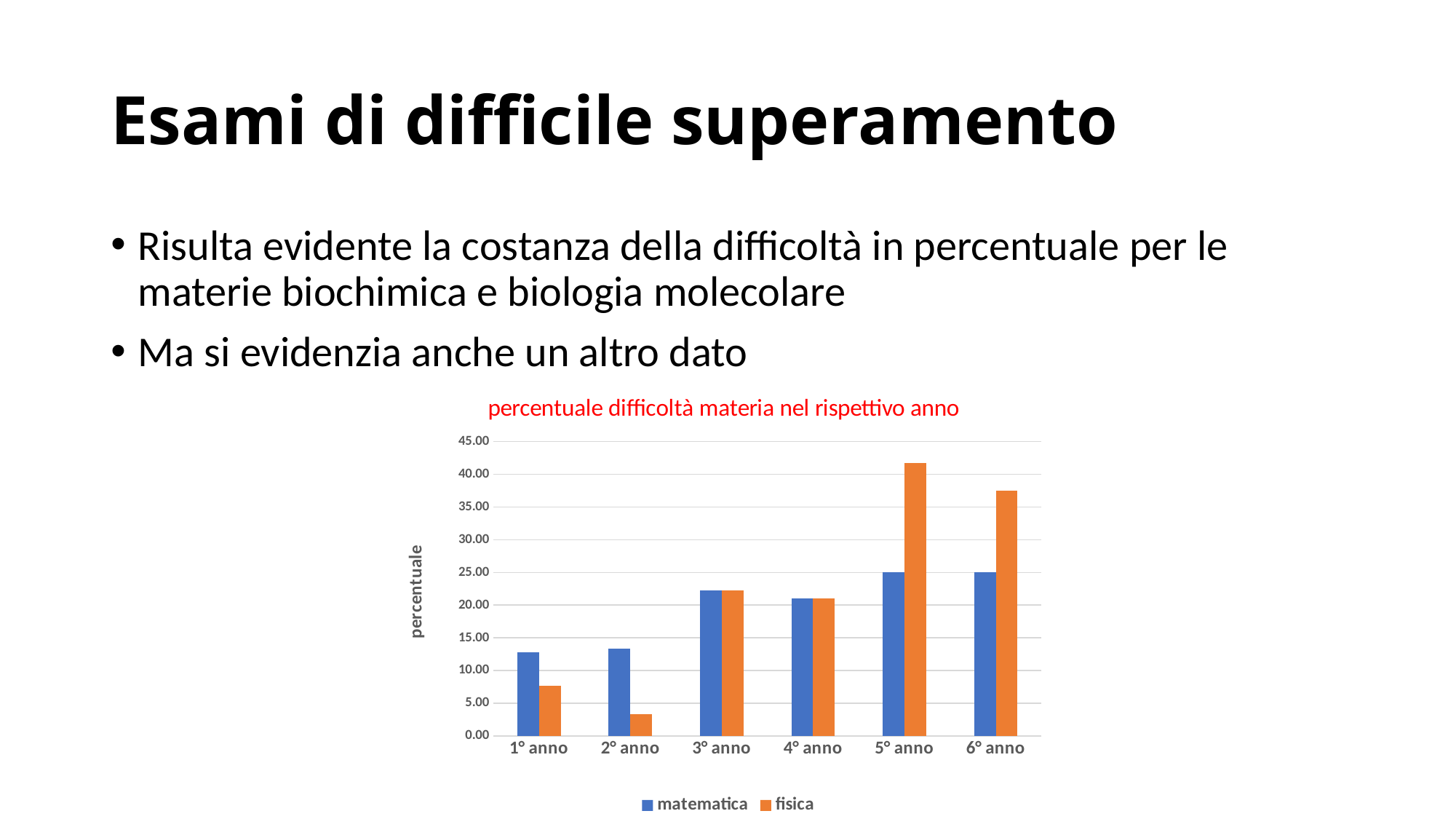
Is the value for fisica in 5° anno greater or less than 40.00? greater In which year is the value for fisica highest? 5° anno In which year is the value for fisica lowest? 2° anno How many year categories are shown on the x axis? 6 Is the value for fisica in 2° anno greater or less than 5.00? less What kind of chart is shown on the slide? bar chart What is the title of the chart? percentuale difficoltà materia nel rispettivo anno Does the value for fisica rise or fall from 1° anno to 2° anno? fall Is the value for matematica in 3° anno greater or less than 20.00? greater In 5° anno, which series has the larger value, matematica or fisica? fisica In 1° anno, which series has the larger value, matematica or fisica? matematica How many series does the legend list? 2